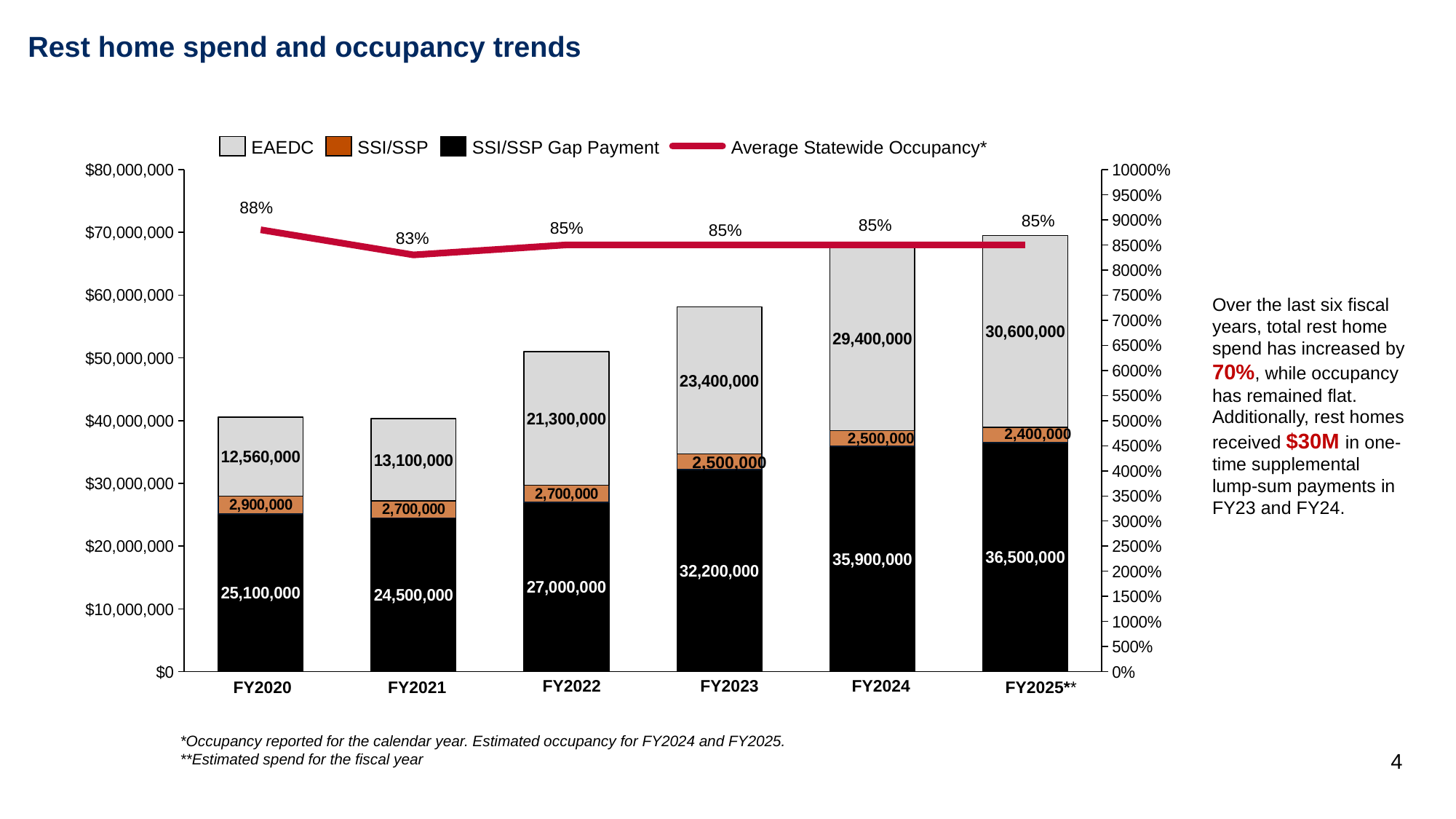
How many series does the legend list? 4 Which fiscal year has the lowest SSI/SSP Gap Payment value? FY2021 What is the Average Statewide Occupancy for FY2021? 83% What is the EAEDC value for FY2020? 12,560,000 Is the total stacked bar for FY2022 greater or less than $40,000,000? greater How many fiscal years are shown on the x axis? 6 What is the SSI/SSP Gap Payment value for FY2023? 32,200,000 What is the difference between the EAEDC values for FY2024 and FY2023? 6,000,000 What is the total of the stacked bar for FY2025**? 69,500,000 Does the SSI/SSP Gap Payment value rise or fall from FY2021 to FY2025**? rise Which fiscal year has the highest EAEDC value? FY2025** Which is larger, the SSI/SSP value for FY2020 or for FY2025**? FY2020